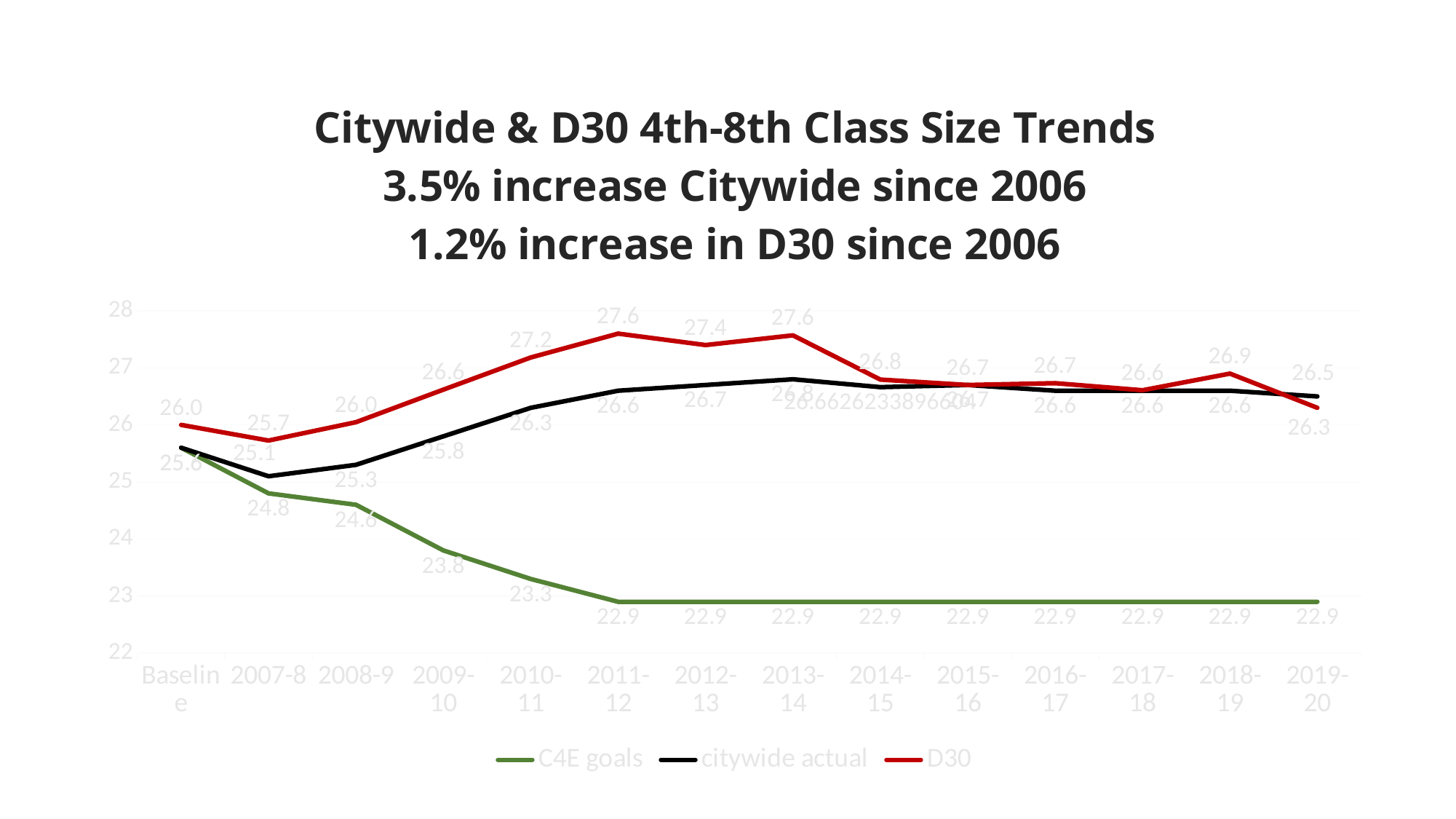
In which year is the D30 value lowest? 2007-8 What is the C4E goals value for 2009-10? 23.8 Which is larger in 2010-11, the D30 value or the citywide actual value? D30 In which year is the citywide actual value lowest? 2007-8 Do the C4E goals values rise or fall from Baseline to 2011-12? fall How many categories are shown along the x axis? 14 How many series does the legend list? 3 What kind of chart is shown on the slide? line chart Is the D30 value for 2012-13 greater or less than 27? greater What is the citywide actual value for 2010-11? 26.3 What is the difference between the D30 value and the citywide actual value in 2011-12? 1.0 What is the D30 value for 2011-12? 27.6